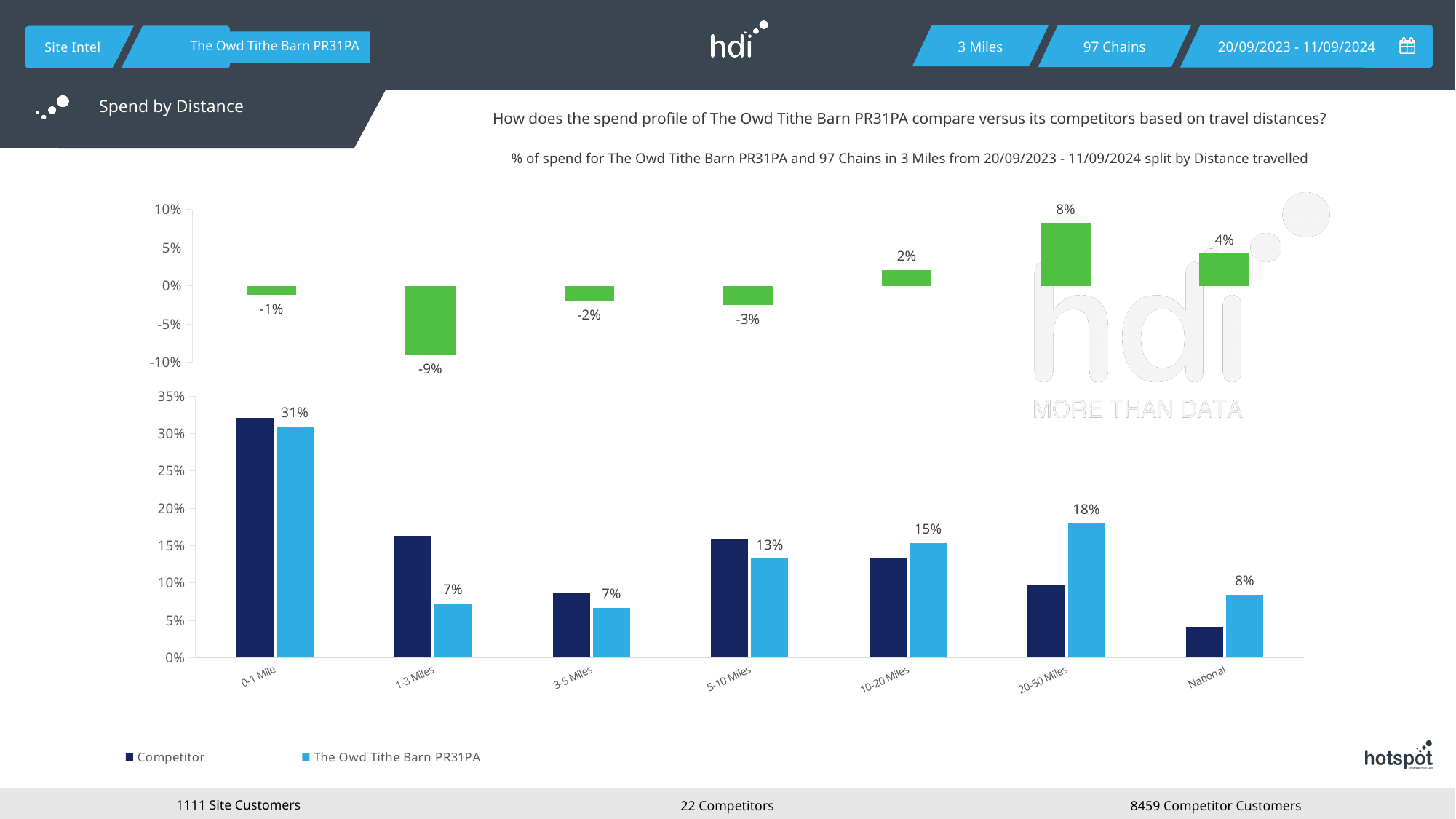
In the bottom chart, which is larger in the 10-20 Miles category: Competitor or The Owd Tithe Barn PR31PA? The Owd Tithe Barn PR31PA In the top chart, which category has the highest value? 20-50 Miles In the bottom chart, which category has the highest value for The Owd Tithe Barn PR31PA? 0-1 Mile In the bottom chart, what is the value for The Owd Tithe Barn PR31PA in the 0-1 Mile category? 31% In the top chart, what is the value shown for the 1-3 Miles category? -9% In the bottom chart, is the Competitor value for 1-3 Miles greater or less than 15%? greater In the bottom chart, what is the value for The Owd Tithe Barn PR31PA in the National category? 8% In the bottom chart, what is the value for The Owd Tithe Barn PR31PA in the 20-50 Miles category? 18% In the bottom chart, what is the difference between The Owd Tithe Barn PR31PA values for 0-1 Mile and 20-50 Miles? 13% In the top chart, which category has the lowest value? 1-3 Miles How many series does the legend of the bottom chart list? 2 How many categories are shown on the x axis of the bottom chart? 7